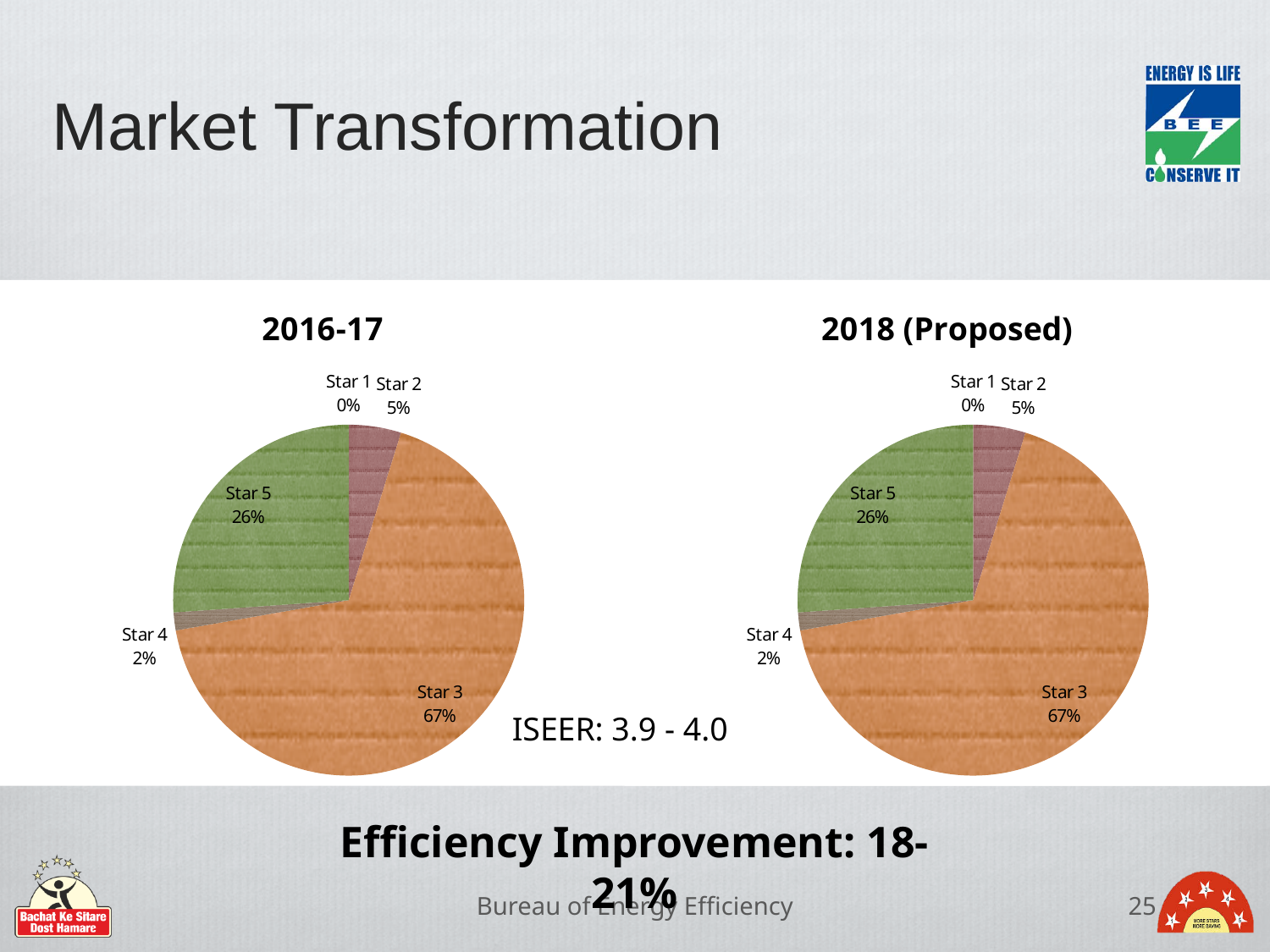
In the 2016-17 chart, what share does Star 1 have? 0% In the 2018 (Proposed) chart, which category has the smallest share? Star 1 In the 2016-17 chart, which category has the largest slice? Star 3 What type of chart is the 2018 (Proposed) chart? Pie chart In the 2018 (Proposed) chart, what share does Star 5 have? 26% In the 2016-17 chart, what is the difference between the shares of Star 3 and Star 5? 41% In the 2016-17 chart, what share does Star 2 have? 5% In the 2016-17 chart, what share does Star 3 have? 67% In the 2018 (Proposed) chart, what share does Star 4 have? 2% How many categories are shown in the 2016-17 chart? 5 In the 2018 (Proposed) chart, which is larger, the share of Star 2 or the share of Star 4? Star 2 What is the title of the chart on the right side of the slide? 2018 (Proposed)